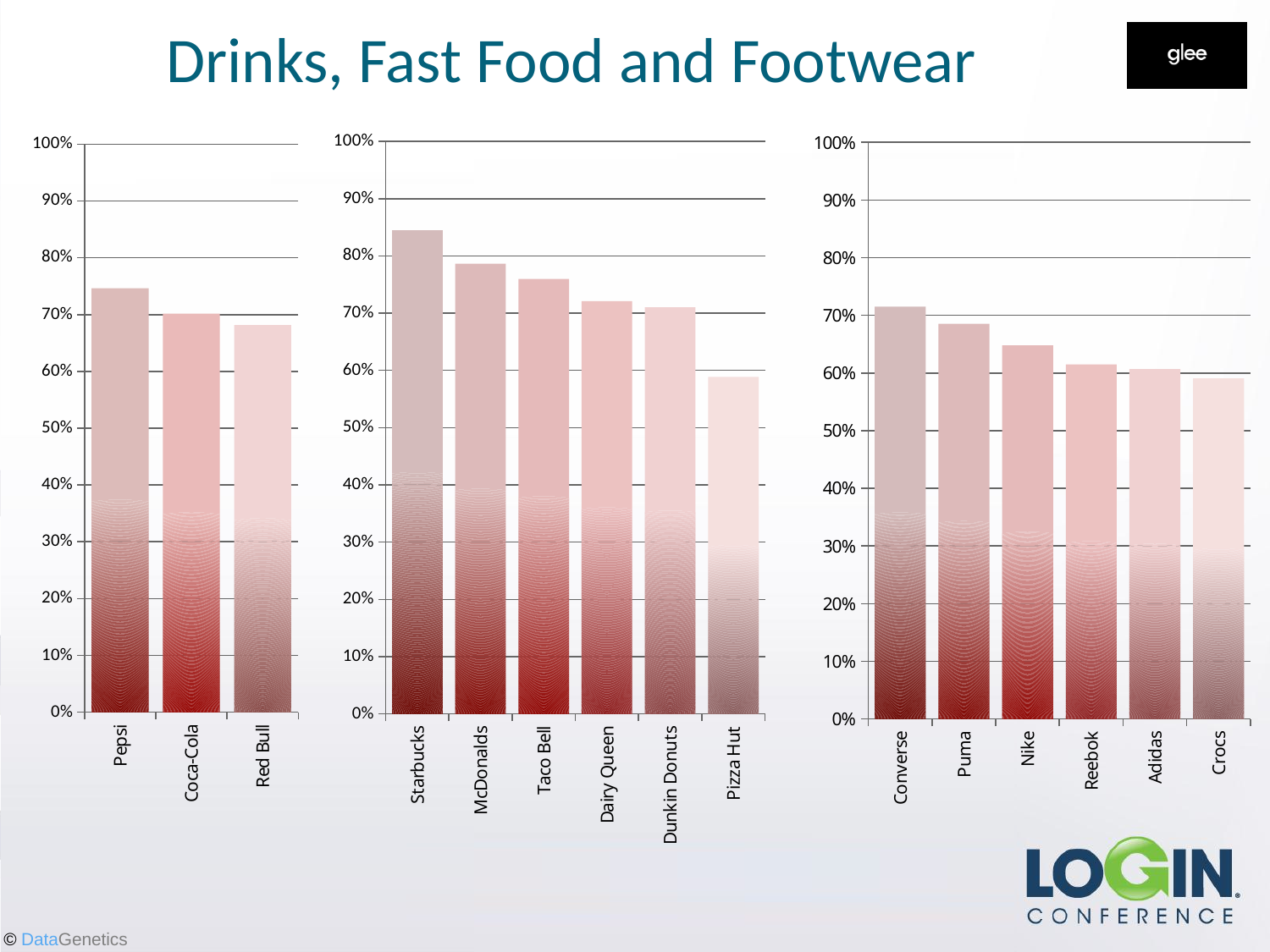
In the right chart, which footwear brand has the highest value? Converse In the left chart, is the value for Pepsi greater or less than 70%? greater In the left chart, is the value for Red Bull greater or less than 70%? less In the middle chart, is the value for Starbucks greater or less than 80%? greater In the middle chart, which fast food brand has the highest value? Starbucks In the left chart, which drink brand has the highest value? Pepsi How many categories are shown in the middle chart (Starbucks to Pizza Hut)? 6 In the middle chart, which fast food brand has the lowest value? Pizza Hut What kind of chart is the left chart showing Pepsi, Coca-Cola and Red Bull? bar chart In the middle chart, do the values rise or fall from Starbucks to Pizza Hut along the x axis? fall In the right chart, which is larger, the value for Converse or the value for Crocs? Converse